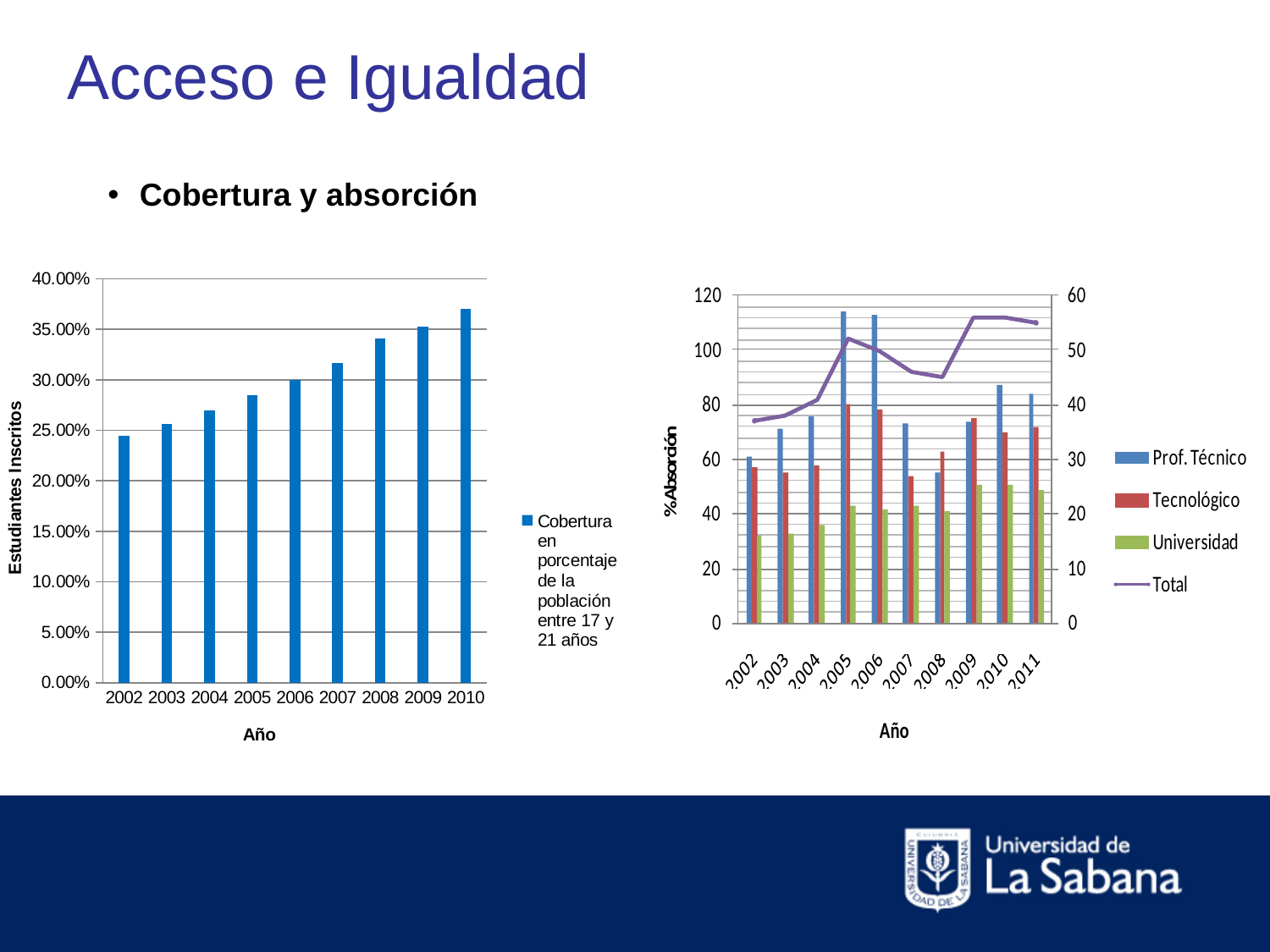
On the left chart, which year has the lowest value for Cobertura? 2002 On the right chart, how many series does the legend list? 4 What kind of chart is the left chart? bar chart On the right chart, is the Prof. Técnico value for 2005 greater or less than 100? greater On the left chart, how many years are shown on the x axis? 9 On the left chart, which year has the highest value for Cobertura? 2010 On the left chart, is the value for 2010 greater or less than 35.00%? greater On the left chart, do the Cobertura values rise or fall from 2002 to 2010? rise On the right chart, in 2005, which is larger: Prof. Técnico or Universidad? Prof. Técnico On the right chart, how many years are shown on the x axis? 10 On the right chart, in which year is the Prof. Técnico bar highest? 2005 On the left chart, is the value for 2002 greater or less than 25.00%? less